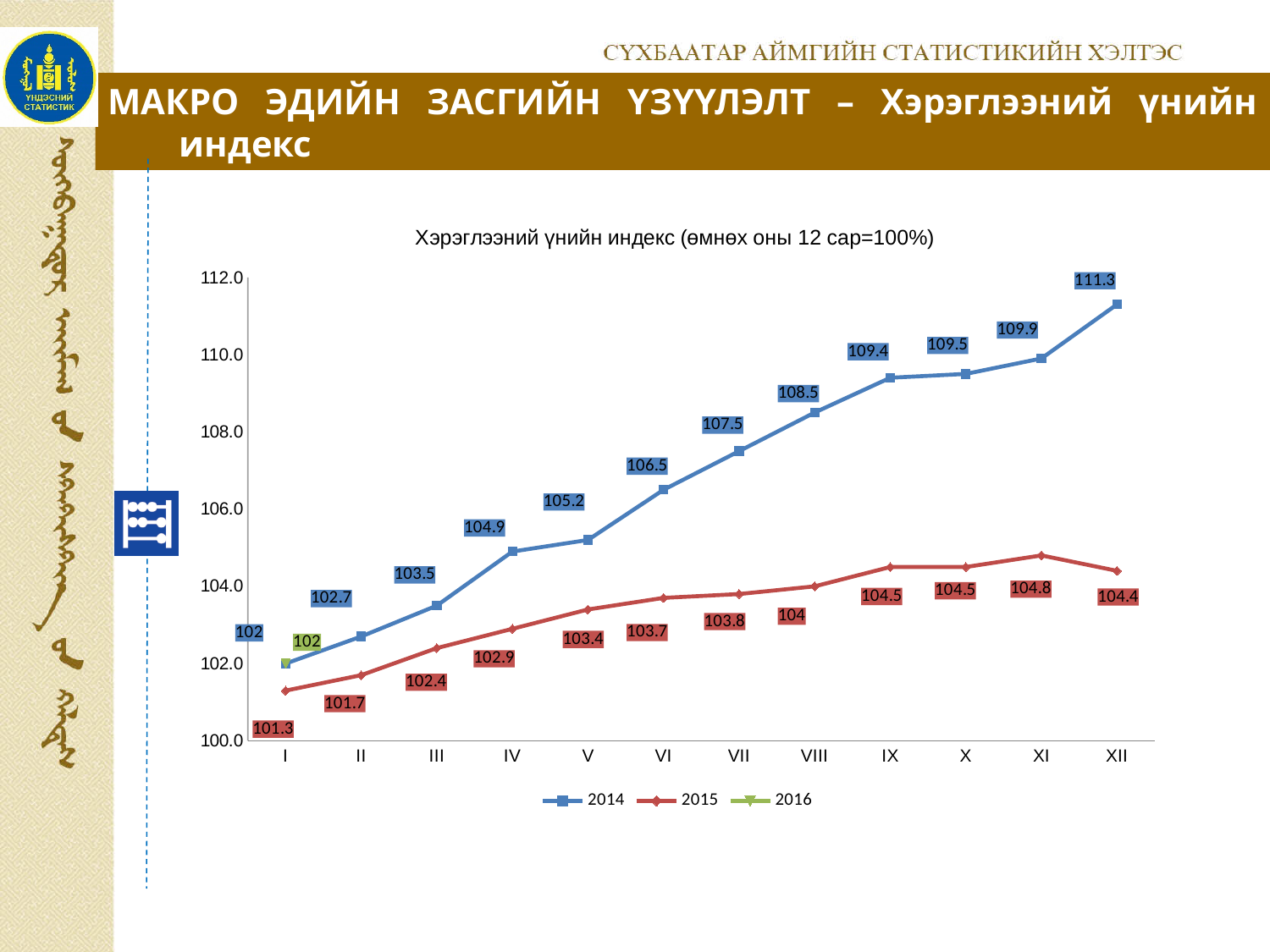
What is the value for 2015 in month VIII? 104 What is the value for 2016 in month I? 102 What is the difference between the 2014 and 2015 values in month XII? 6.9 How many series does the legend list? 3 How many months are shown on the x axis? 12 What type of chart is shown on the slide? line chart Does the 2014 series rise or fall from month I to month XII? rise What is the value for 2014 in month XII? 111.3 Which is larger in month IV: the 2014 value or the 2015 value? 2014 What is the title of the chart? Хэрэглээний үнийн индекс (өмнөх оны 12 сар=100%) In which month is the 2014 series at its lowest? I In which month is the 2015 series at its highest? XI